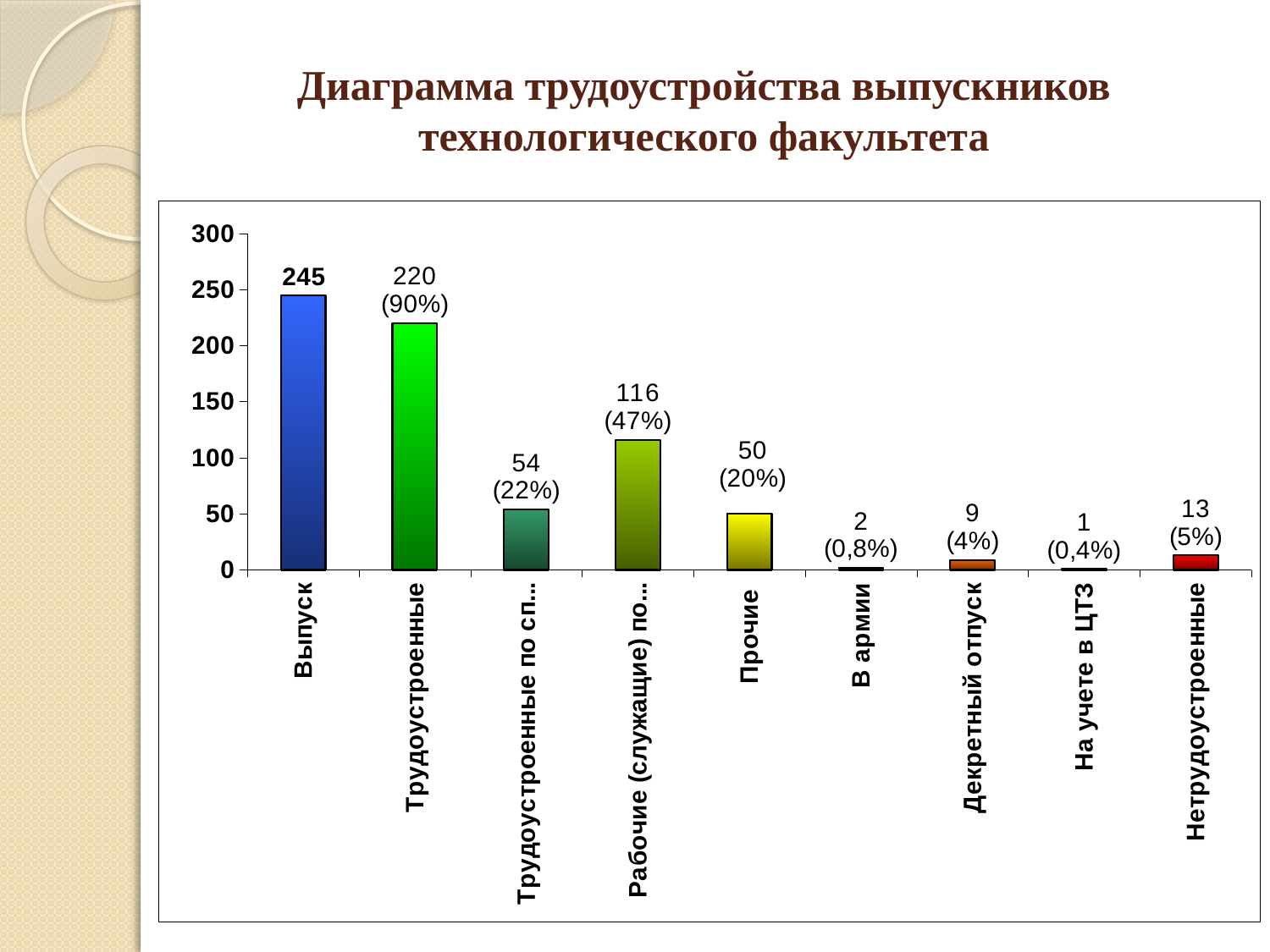
What is the value for Трудоустроенные? 220 What kind of chart is shown on the slide? Bar chart What is the title of the slide? Диаграмма трудоустройства выпускников технологического факультета What is the value for Нетрудоустроенные? 13 What is the difference between the values for Выпуск and Трудоустроенные? 25 Which is larger, the value for Декретный отпуск or the value for Нетрудоустроенные? Нетрудоустроенные How many categories are shown on the x axis? 9 What is the value for Выпуск? 245 What percentage is shown for Декретный отпуск? 4% Which category has the lowest value? На учете в ЦТЗ Which category has the highest value? Выпуск What percentage is shown for Прочие? 20%